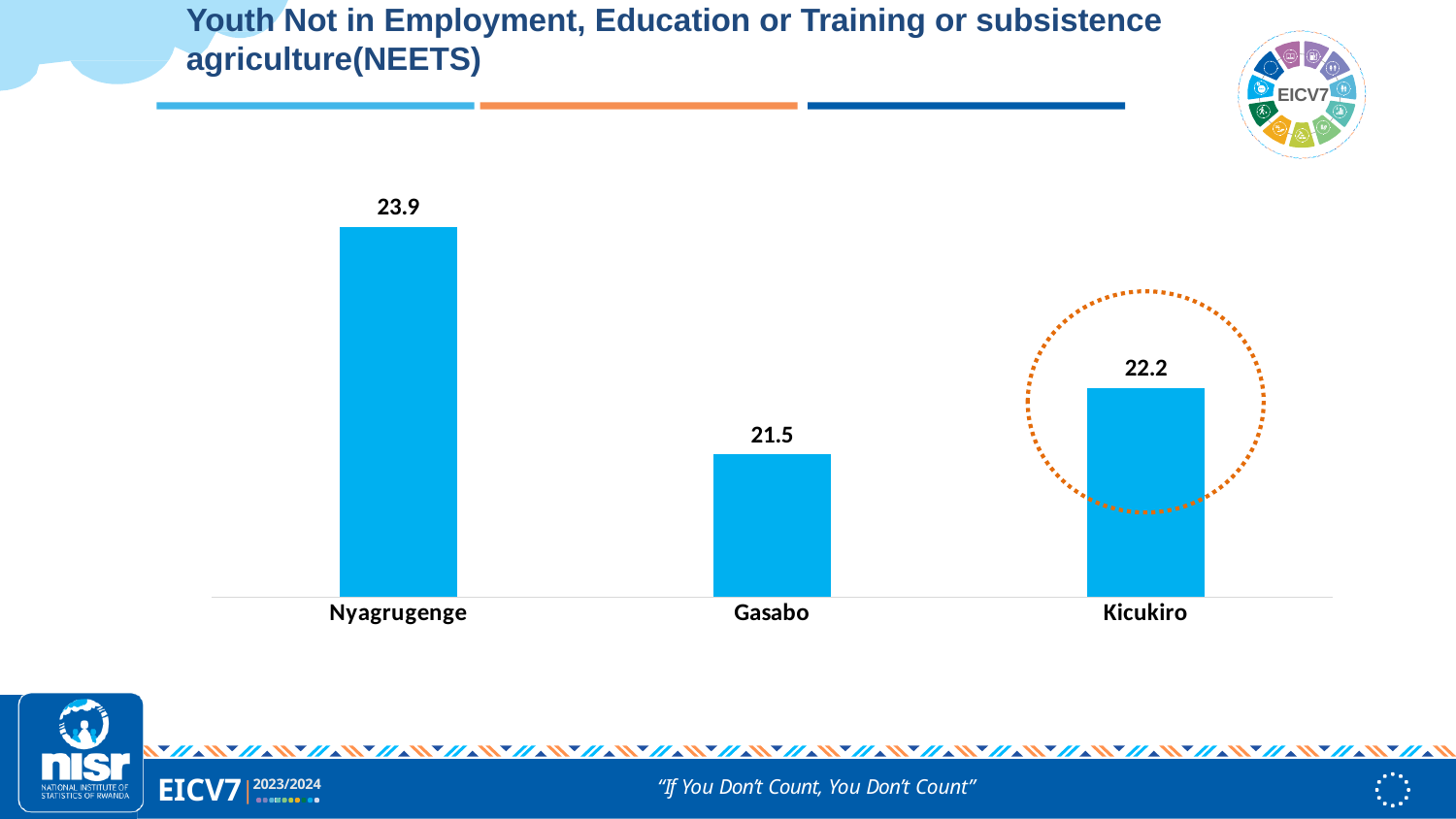
Which is larger, the value for Kicukiro or the value for Gasabo? Kicukiro Which district has the highest value? Nyagrugenge What is the difference between the values for Nyagrugenge and Gasabo? 2.4 What kind of chart is shown on the slide? Bar chart What is the difference between the values for Kicukiro and Gasabo? 0.7 What is the value for Nyagrugenge? 23.9 What is the value for Kicukiro? 22.2 What is the title of the slide? Youth Not in Employment, Education or Training or subsistence agriculture(NEETS) Which district has the lowest value? Gasabo Which district's bar is highlighted with a dotted orange circle? Kicukiro What is the value for Gasabo? 21.5 How many districts are shown in the chart? 3